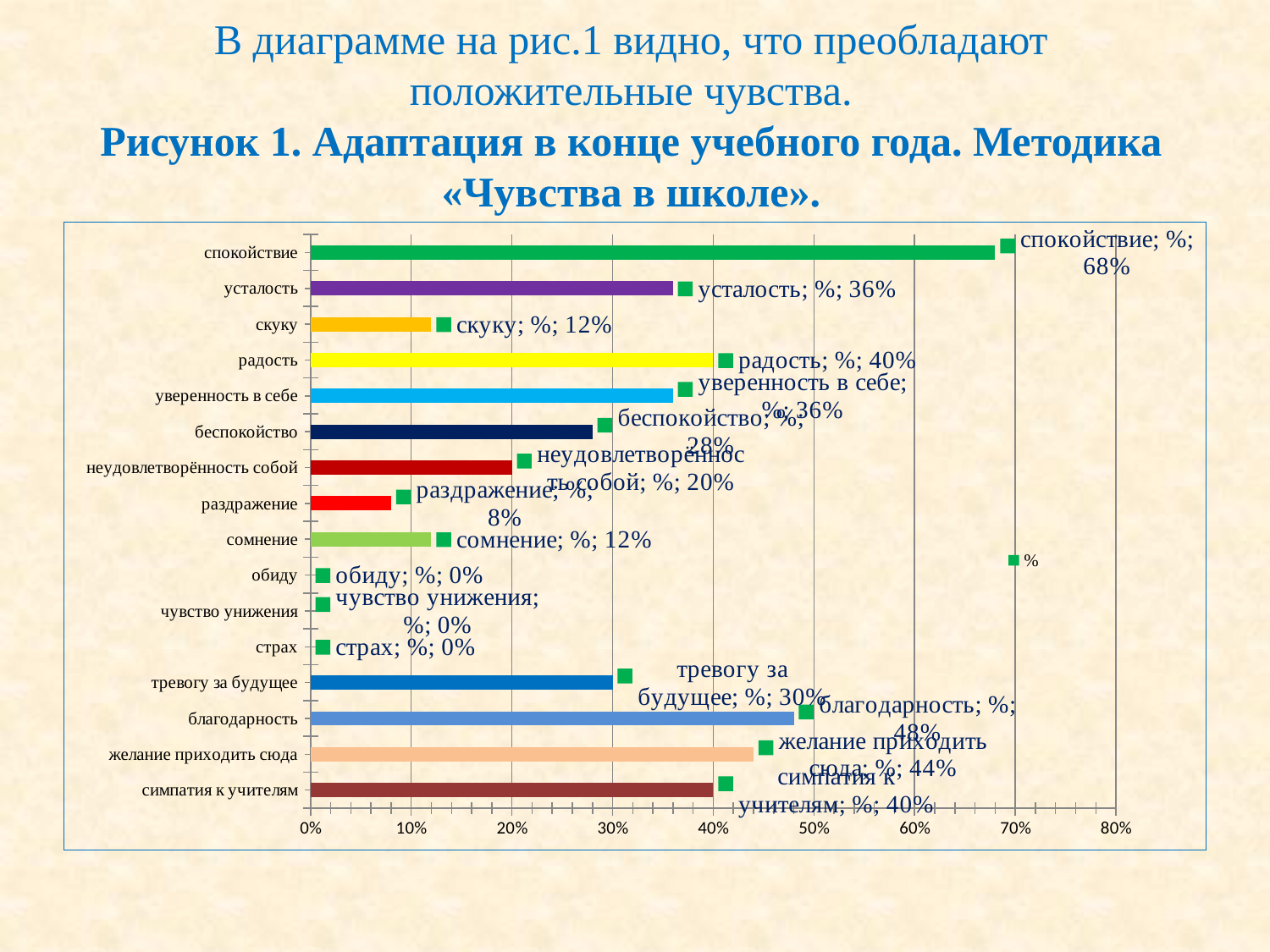
What is the value for раздражение? 8% What is the value for благодарность? 48% What is the difference between the values for спокойствие and благодарность? 20% Which category has the highest value? спокойствие What kind of chart is shown on the slide? bar chart What is the value for спокойствие? 68% What is the difference between the values for тревогу за будущее and скуку? 18% Is the value for желание приходить сюда greater or less than 40%? greater How many categories are shown on the chart? 16 What is the value for беспокойство? 28% Which is larger, the value for радость or the value for усталость? радость How many series does the legend list? 1